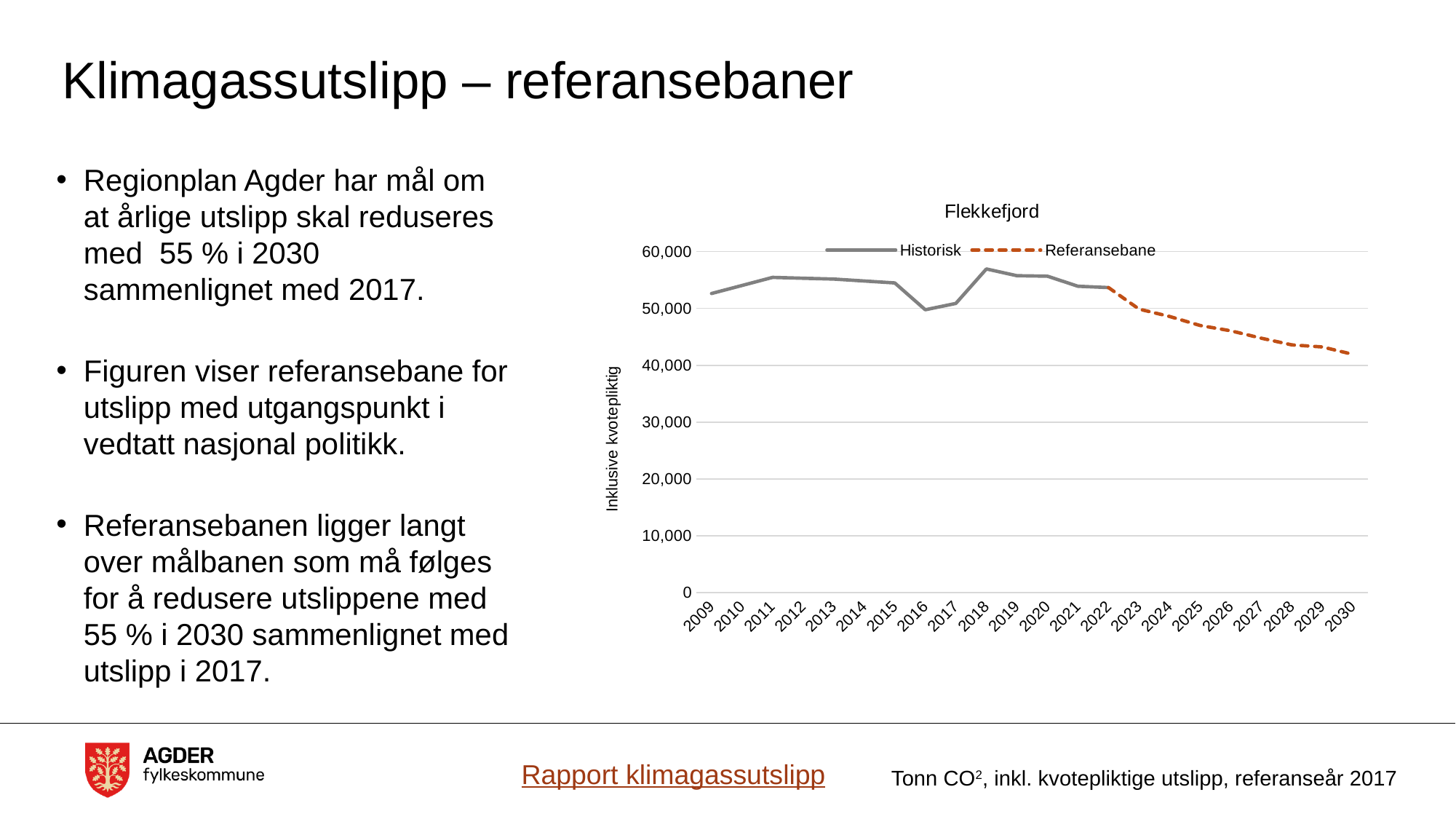
How many years are shown on the x axis of the chart? 22 In which year does the Historisk series reach its lowest value? 2016 What is the title of the chart? Flekkefjord Is the value for 2030 on the Referansebane series greater or less than 40,000? greater What kind of chart is shown on the slide? Line chart Does the Referansebane series rise or fall from 2022 to 2030? fall How many series does the chart legend list? 2 Which is larger, the Historisk value for 2018 or for 2016? 2018 Which series is drawn as a dashed line in the chart? Referansebane Is the value for 2030 on the Referansebane series greater or less than 50,000? less Is the value for 2018 on the Historisk series greater or less than 50,000? greater In which year does the Historisk series reach its highest value? 2018